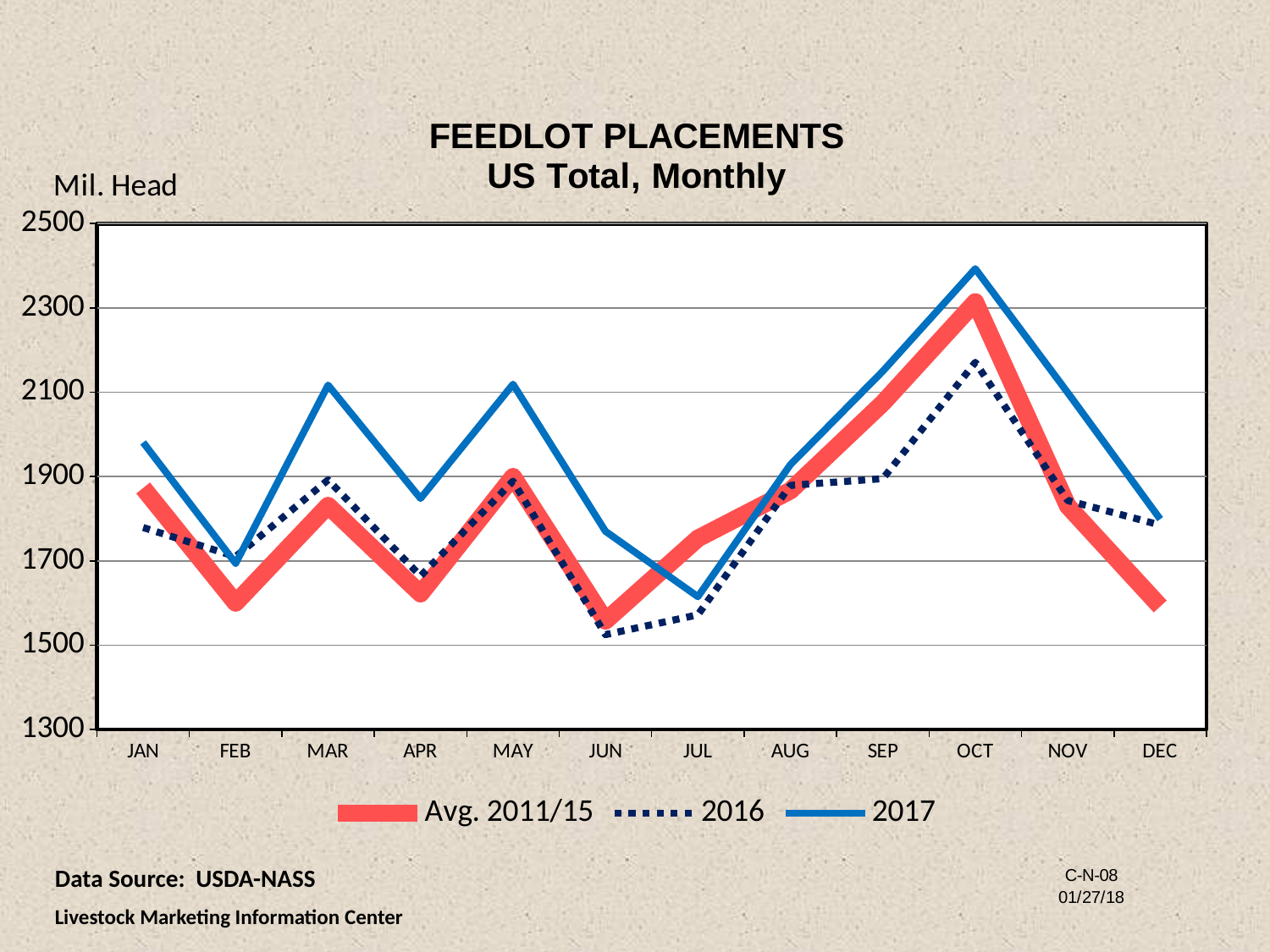
Does the 2017 series rise or fall from OCT to DEC? fall How many months are shown along the x axis? 12 In which month does the 2017 series reach its highest value? OCT In JUL, which is larger: the Avg. 2011/15 value or the 2017 value? Avg. 2011/15 How many series does the legend list? 3 In which month does the Avg. 2011/15 series reach its highest value? OCT Is the 2017 value for OCT greater or less than 2300? greater Is the Avg. 2011/15 value for DEC greater or less than 1700? less In which month does the 2016 series reach its lowest value? JUN What kind of chart is shown on the slide? line chart Is the 2016 value for JUN greater or less than 1700? less What is the label on the y axis of the chart? Mil. Head